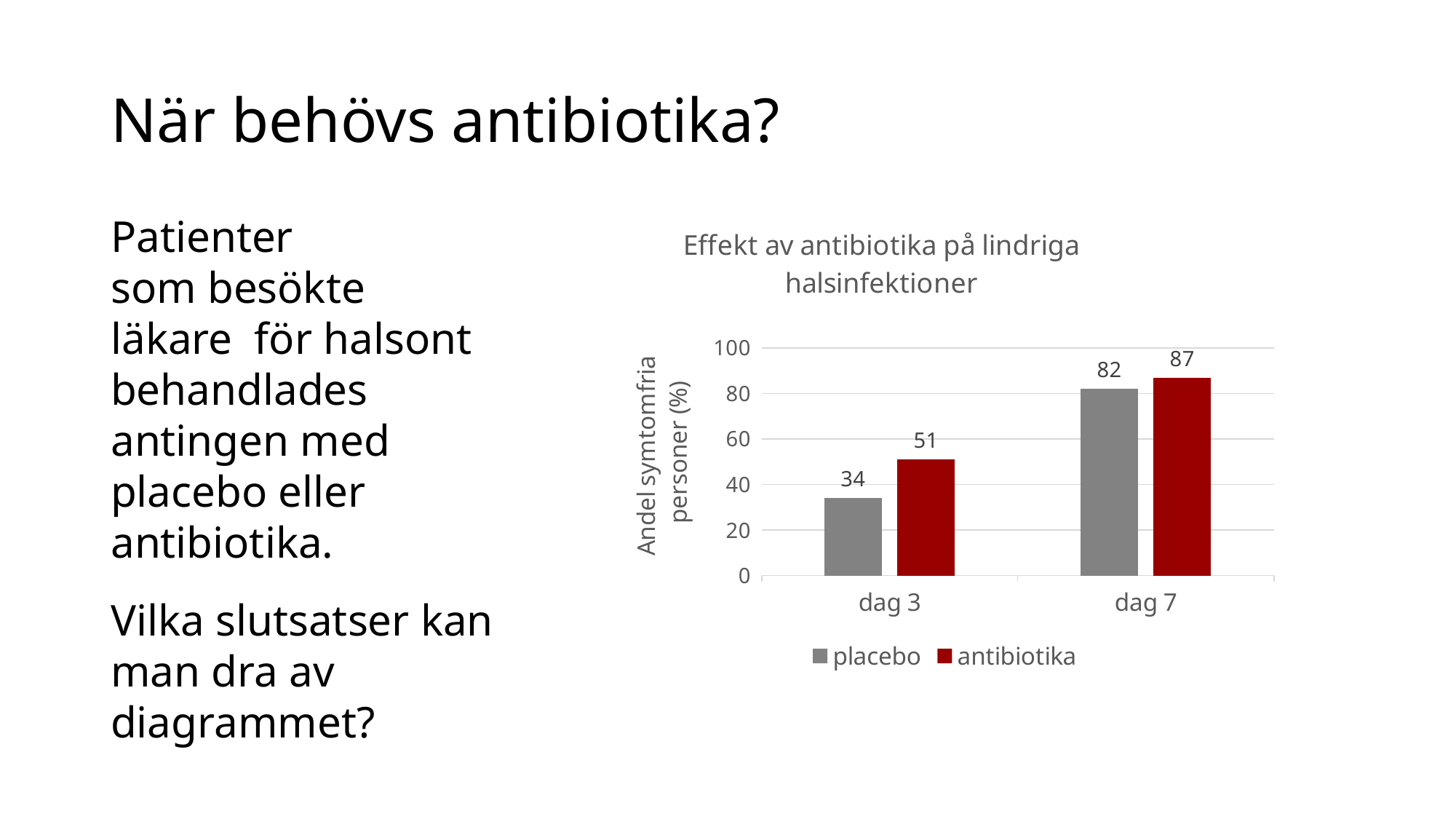
What is the value for placebo at dag 7? 82 What kind of chart is shown on the slide? bar chart What is the value for antibiotika at dag 7? 87 Which is larger at dag 3, placebo or antibiotika? antibiotika Which bar has the highest value in the chart? antibiotika at dag 7 What is the difference between antibiotika and placebo at dag 7? 5 What is the difference between antibiotika and placebo at dag 3? 17 What is the value for placebo at dag 3? 34 How many series does the legend list? 2 What is the title of the chart? Effekt av antibiotika på lindriga halsinfektioner Which bar has the lowest value in the chart? placebo at dag 3 What is the value for antibiotika at dag 3? 51